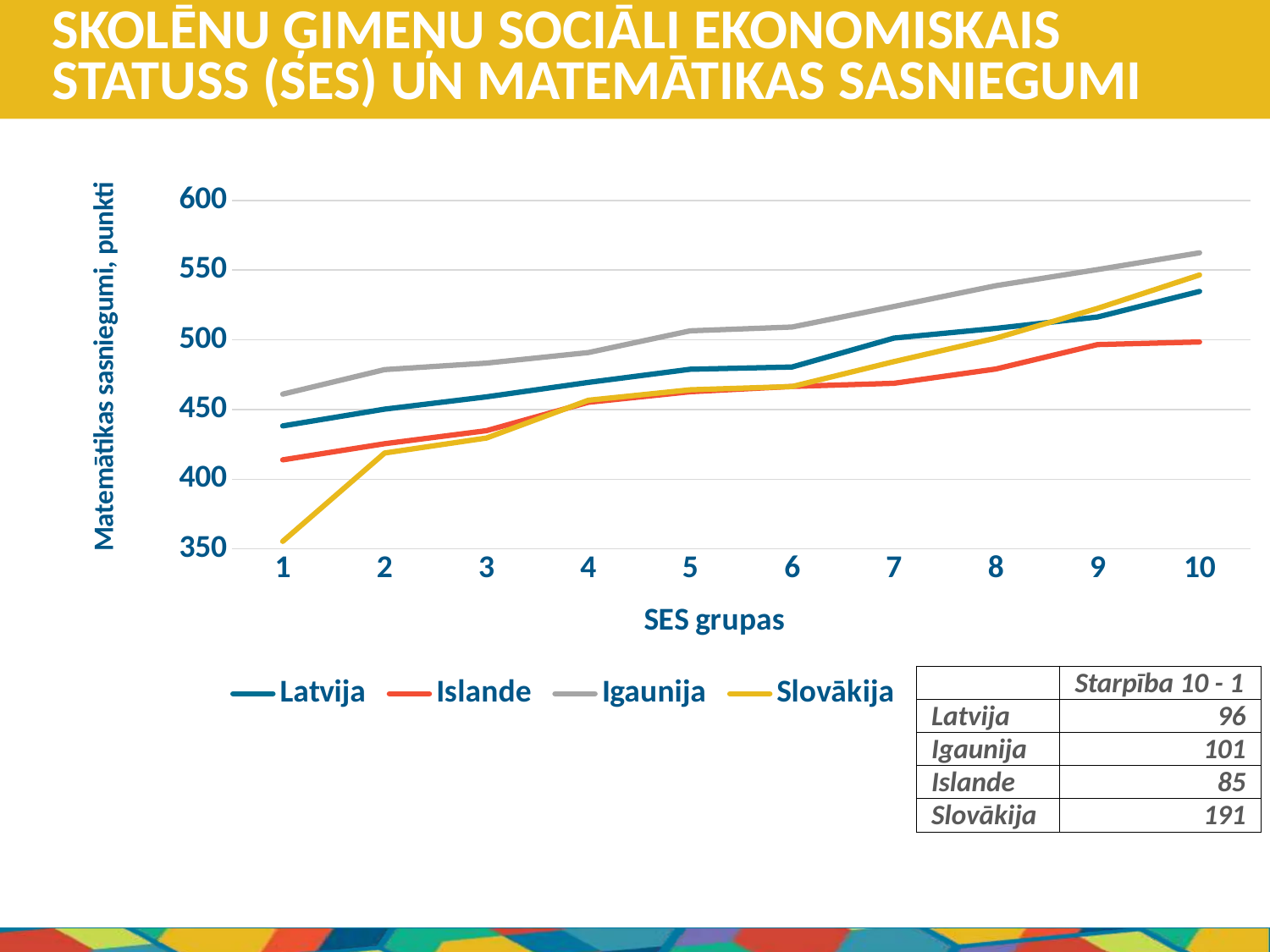
Which colour is used for the Islande line in the chart? red Is the value for Latvija at SES group 5 greater or less than 500? less How many series does the chart legend list? 4 What kind of chart is shown on the slide? line chart Is the value for Igaunija at SES group 10 greater or less than 550? greater Which country has the highest mathematics score at SES group 10? Igaunija Which country has the lowest mathematics score at SES group 1? Slovākija At SES group 2, which has the higher mathematics score, Latvija or Islande? Latvija Do the mathematics scores rise or fall as the SES group increases from 1 to 10? rise What is the label of the y axis of the chart? Matemātikas sasniegumi, punkti How many SES groups are shown along the x axis? 10 Is the value for Slovākija at SES group 1 greater or less than 400? less